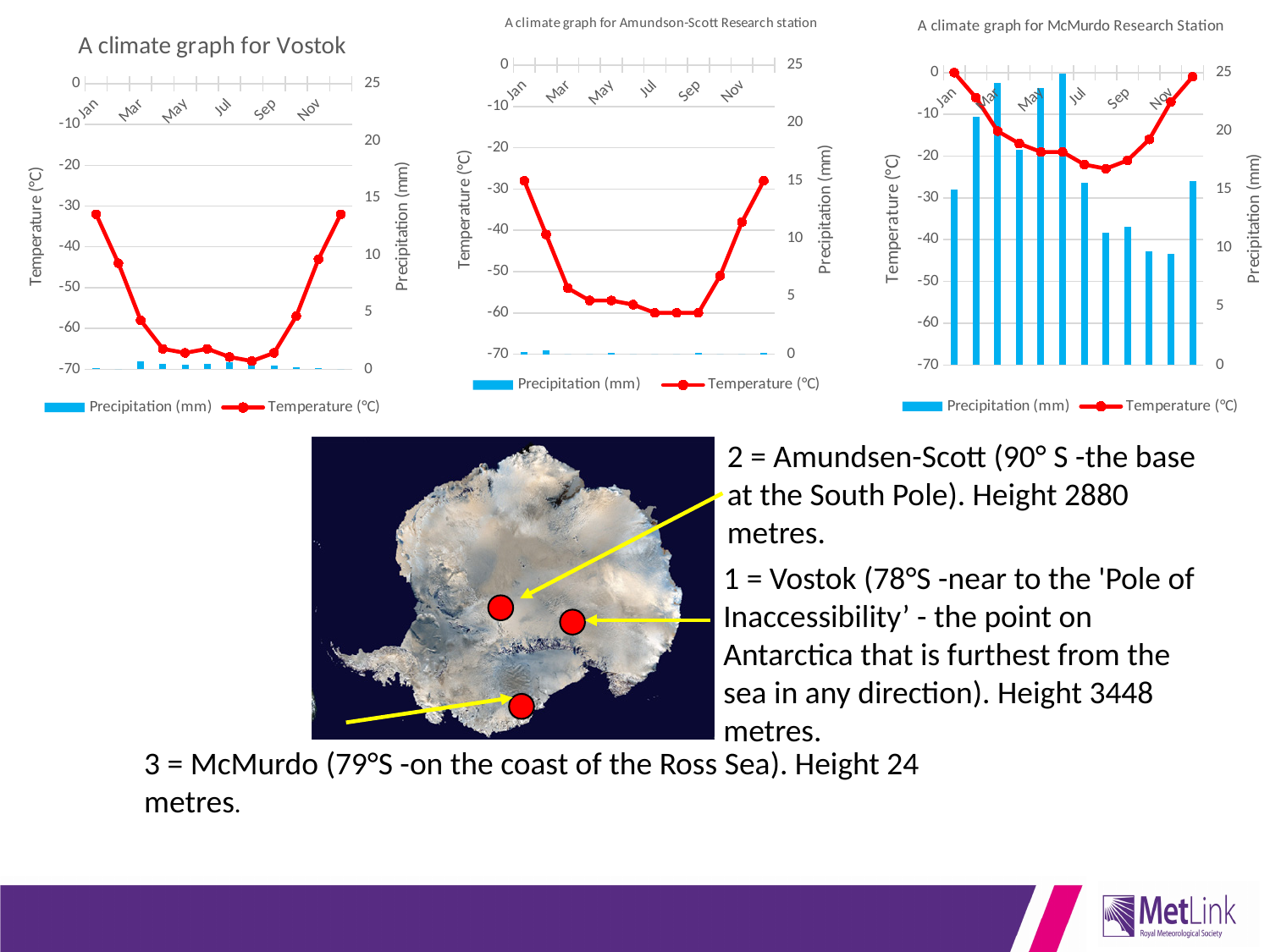
In the chart titled 'A climate graph for Amundson-Scott Research station', is the temperature for Jul greater or less than -50? less In the chart titled 'A climate graph for Vostok', how many series does the legend list? 2 In the chart titled 'A climate graph for McMurdo Research Station', which is higher, the precipitation for Feb or for Aug? Feb In the chart titled 'A climate graph for Vostok', does the temperature rise or fall from Jan to Jul? fall In the chart titled 'A climate graph for Vostok', is the temperature for Jan greater or less than -20? less In the chart titled 'A climate graph for McMurdo Research Station', which month has the highest precipitation? Jun In the chart titled 'A climate graph for Vostok', how many months are plotted along the x axis? 12 In the chart titled 'A climate graph for McMurdo Research Station', what kind of chart is used to show precipitation? Bar chart How many charts are on the slide? 3 In the chart titled 'A climate graph for McMurdo Research Station', is the precipitation for Jun greater or less than 20? greater In the chart titled 'A climate graph for Amundson-Scott Research station', what are the two legend entries? Precipitation (mm) and Temperature (°C)